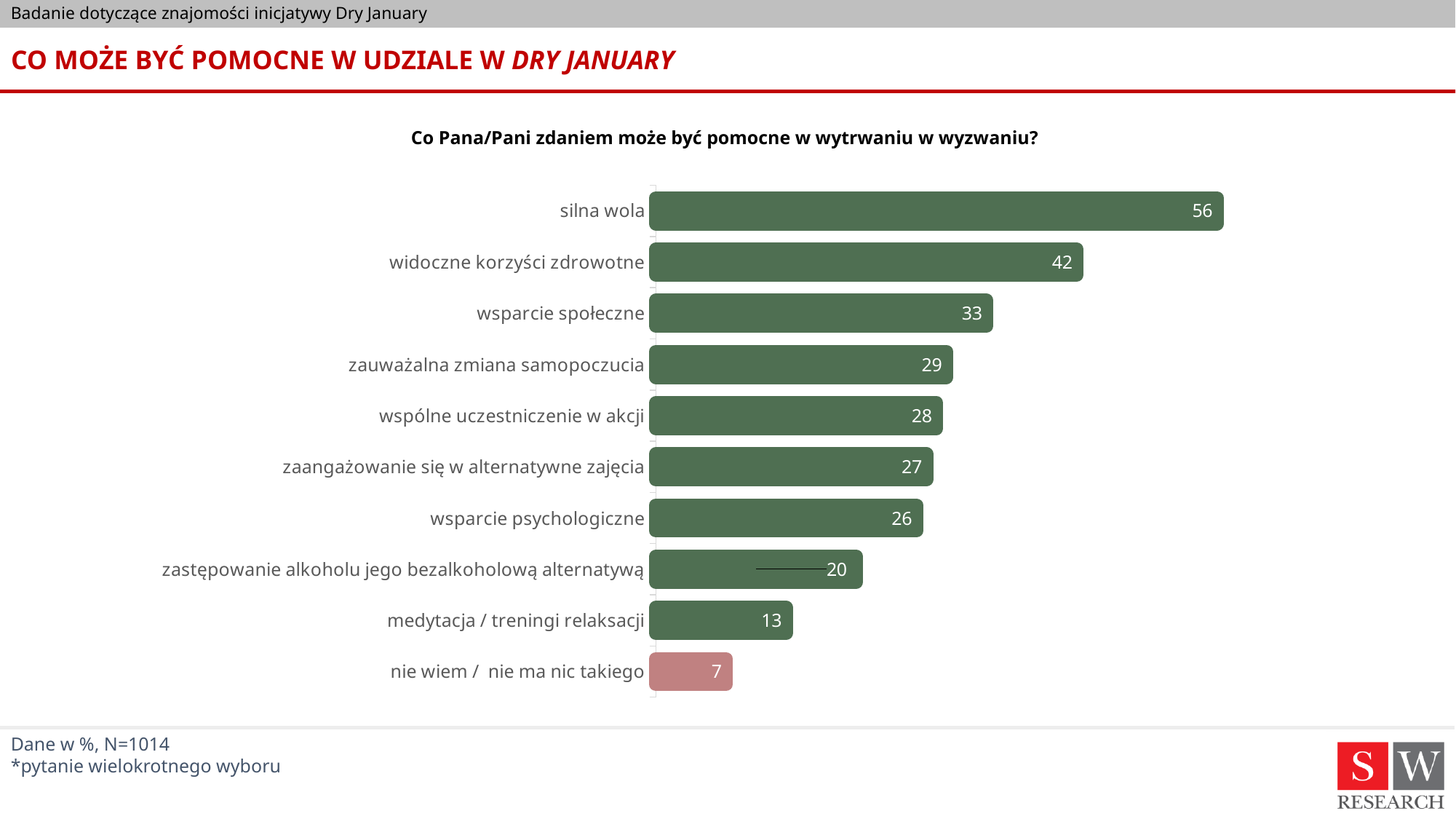
What is the difference between the values for "silna wola" and "widoczne korzyści zdrowotne"? 14 Which category has the highest value? silna wola How many categories are shown in the chart? 10 What kind of chart is shown on the slide? bar chart What is the value for "medytacja / treningi relaksacji"? 13 What is the question shown as the chart title? Co Pana/Pani zdaniem może być pomocne w wytrwaniu w wyzwaniu? What is the value for "silna wola"? 56 What is the difference between the values for "wsparcie społeczne" and "medytacja / treningi relaksacji"? 20 Which is larger: the value for "zauważalna zmiana samopoczucia" or the value for "zastępowanie alkoholu jego bezalkoholową alternatywą"? zauważalna zmiana samopoczucia Which bar is shown in a different colour (pink) from the others? nie wiem / nie ma nic takiego Which category has the lowest value? nie wiem / nie ma nic takiego What is the value for "wsparcie psychologiczne"? 26